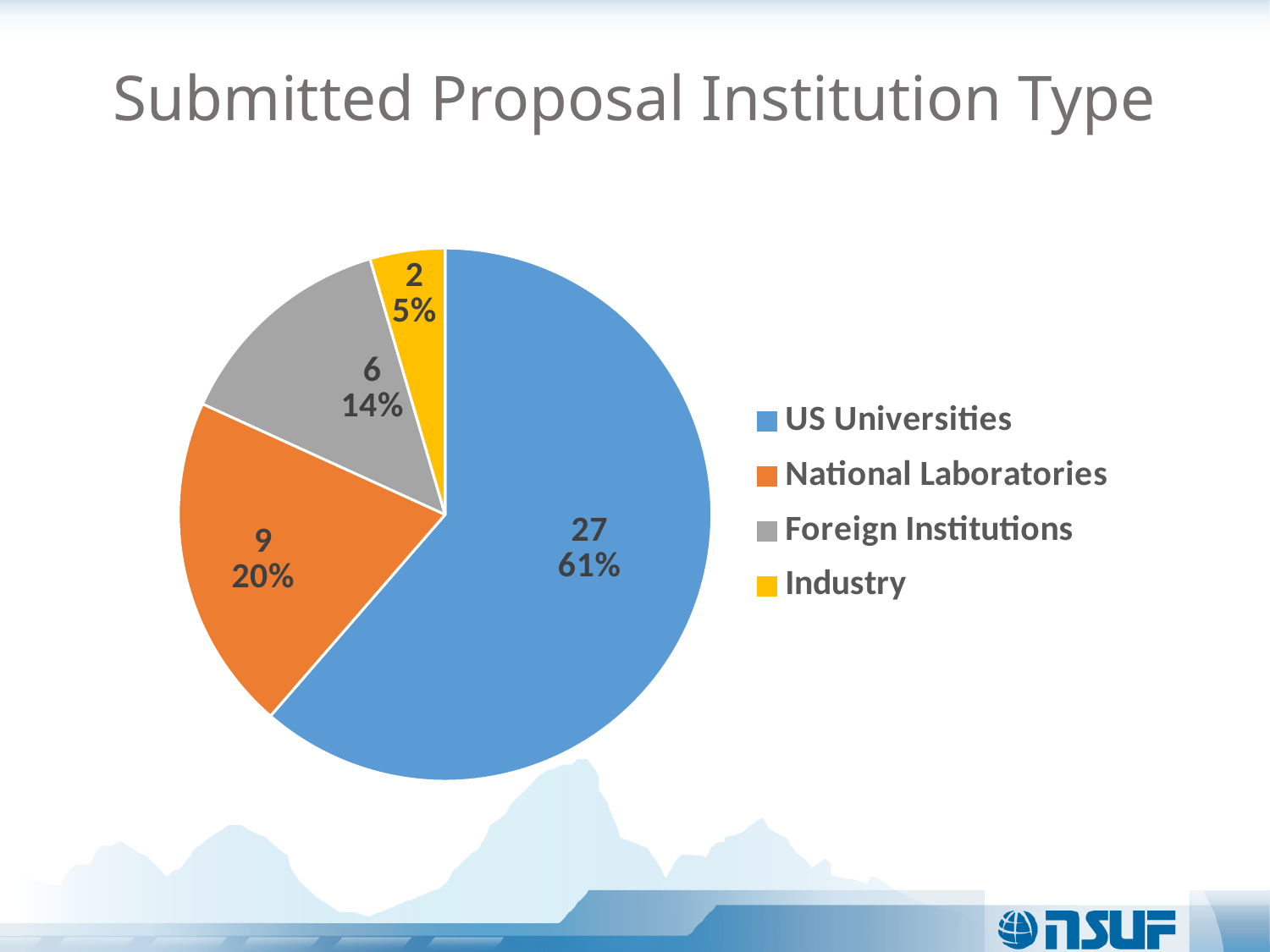
Which has more submitted proposals, Foreign Institutions or Industry? Foreign Institutions How many more proposals came from US Universities than from National Laboratories? 18 How many institution types are shown in the pie chart? 4 Which institution type has the smallest slice of the pie? Industry What type of chart is shown on the slide? pie chart What is the total number of submitted proposals across all institution types? 44 Which institution type has the largest slice of the pie? US Universities How many proposals were submitted by Foreign Institutions? 6 What share of the pie does Industry represent? 5% What percentage of submitted proposals came from National Laboratories? 20% How many proposals were submitted by US Universities? 27 What is the title of the chart? Submitted Proposal Institution Type